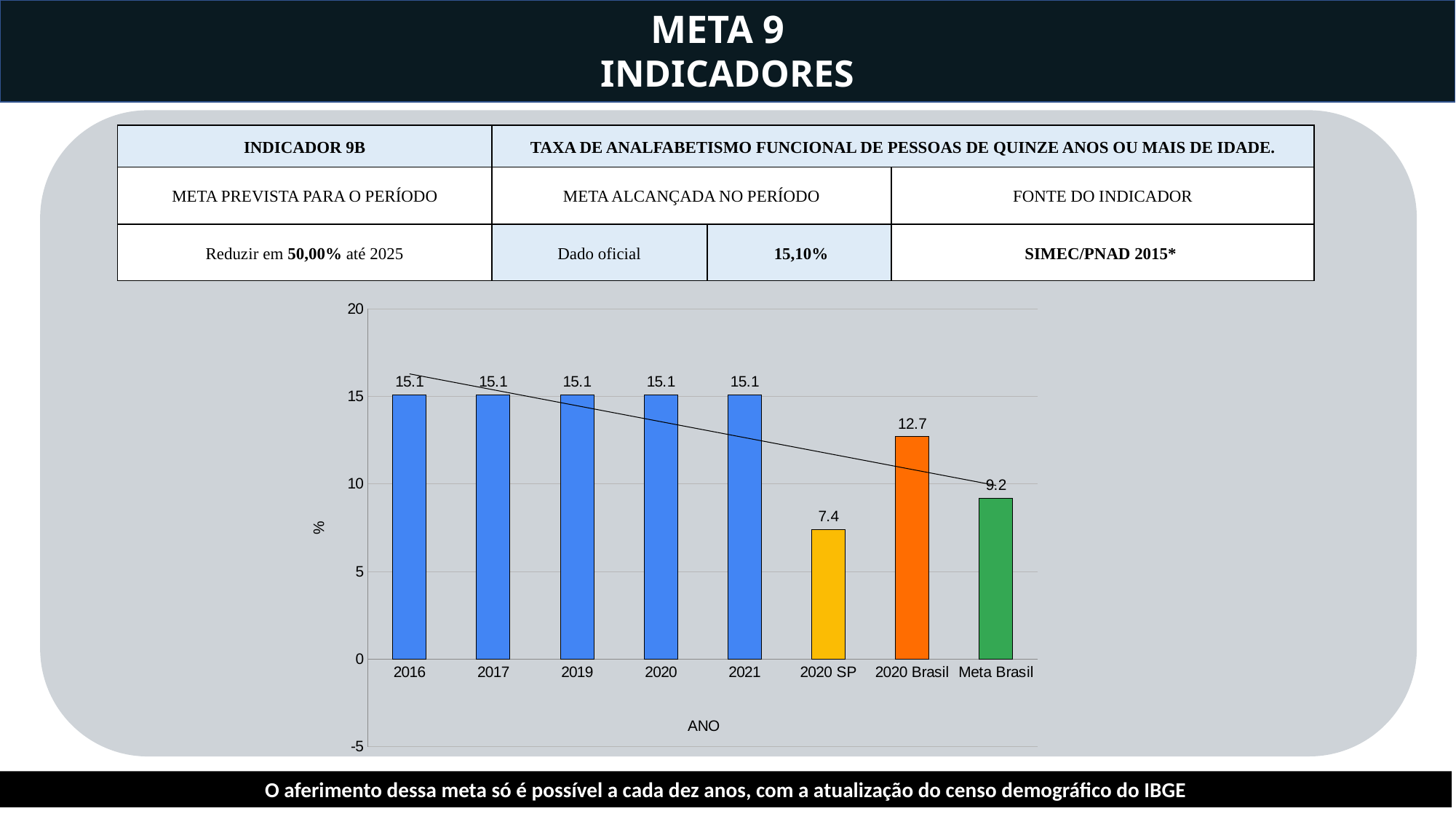
What is the value for 2016? 15.1 What is the value for Meta Brasil? 9.2 What is the value for 2020 SP? 7.4 Is the value for 2020 SP greater or less than 10? less What kind of chart is shown on the slide? bar chart Which is larger, the value for 2020 Brasil or the value for Meta Brasil? 2020 Brasil How many bars are shown in the chart? 8 What is the label of the x axis? ANO What is the difference between the values for 2021 and Meta Brasil? 5.9 What is the value for 2020 Brasil? 12.7 Which category has the lowest value? 2020 SP What is the difference between the values for 2020 Brasil and 2020 SP? 5.3